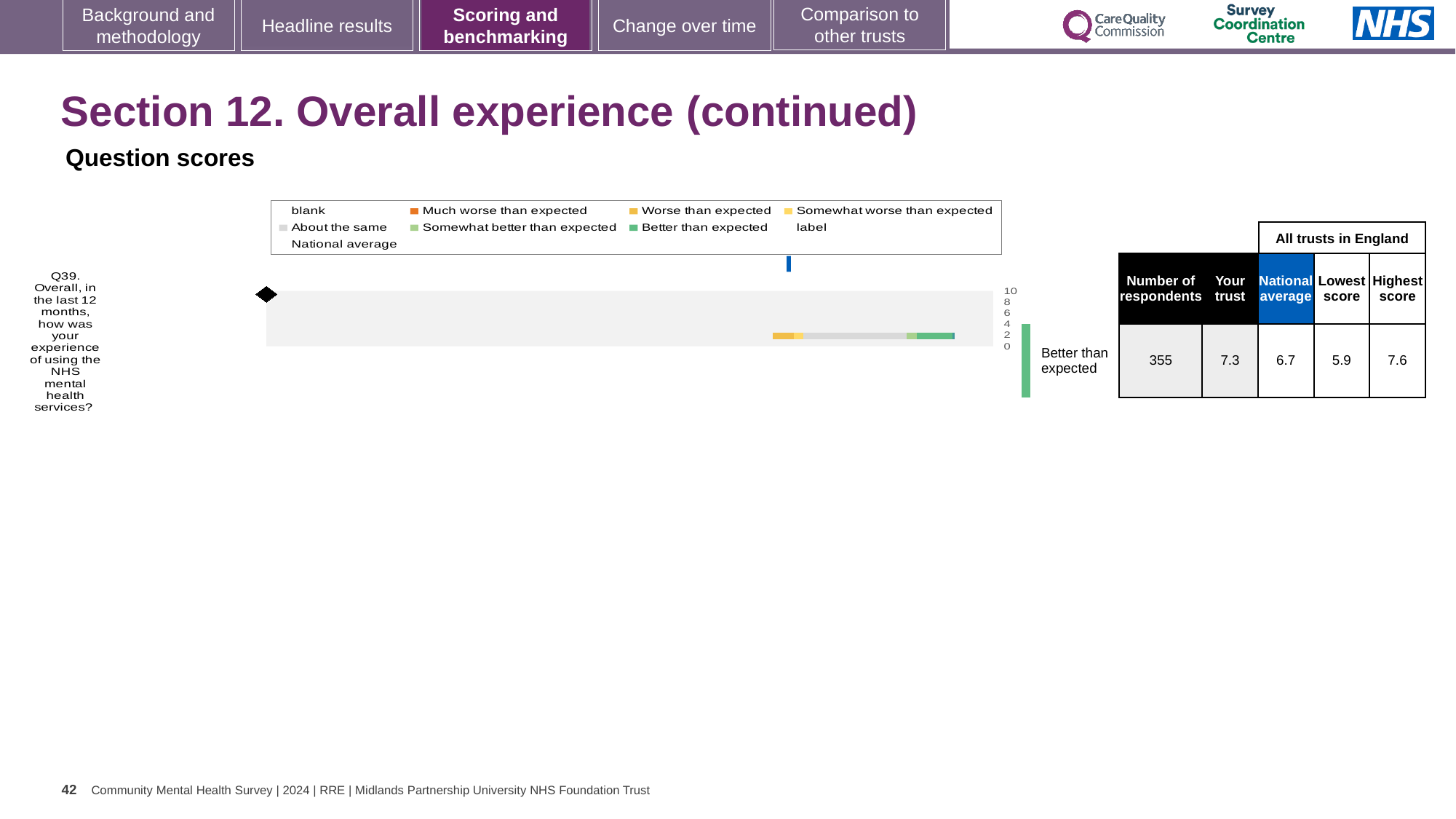
What type of chart is used to show the Q39 question score? bar chart What is the lowest score among all trusts in England for Q39? 5.9 Which survey question is plotted in the chart? Q39. Overall, in the last 12 months, how was your experience of using the NHS mental health services? What is the 'Your trust' score for Q39? 7.3 How many respondents answered Q39? 355 How many survey questions are plotted in the chart? 1 What is the national average score for Q39? 6.7 Which is larger for Q39, the 'Your trust' score or the national average? Your trust What is the difference between the 'Your trust' score and the national average for Q39? 0.6 What colour does the legend use for 'Better than expected'? green What is the highest score among all trusts in England for Q39? 7.6 What benchmarking category is the trust's Q39 result labelled as? Better than expected